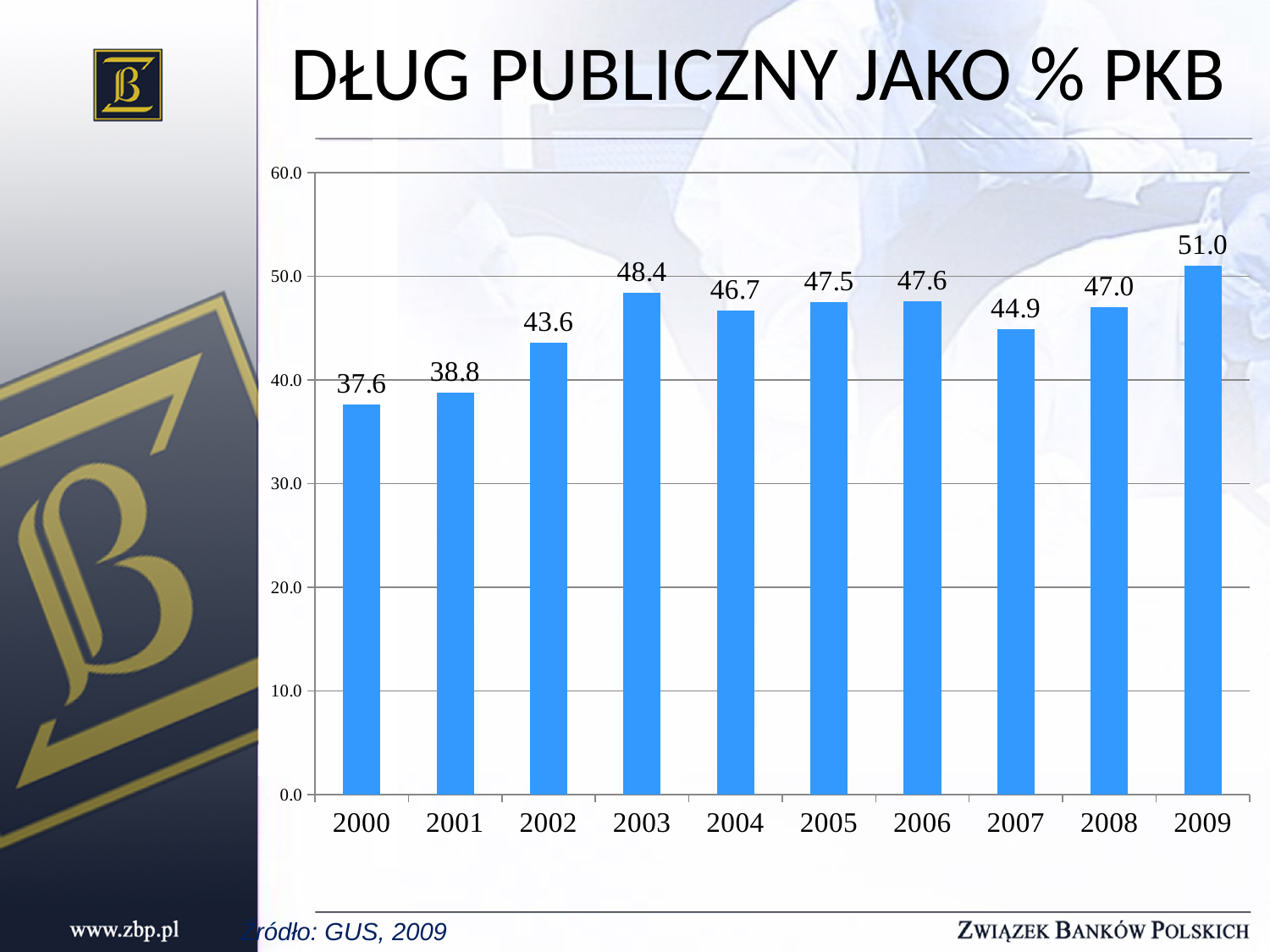
What is the value for 2000? 37.6 What is the value for 2003? 48.4 Is the value for 2009 greater or less than 50.0? greater Which is larger, the value for 2002 or the value for 2008? 2008 What is the difference between the values for 2009 and 2000? 13.4 What is the title of the chart? DŁUG PUBLICZNY JAKO % PKB What kind of chart is shown on the slide? bar chart How many years are shown on the x axis? 10 What is the value for 2007? 44.9 What is the difference between the values for 2003 and 2007? 3.5 Which year has the highest value? 2009 Which year has the lowest value? 2000